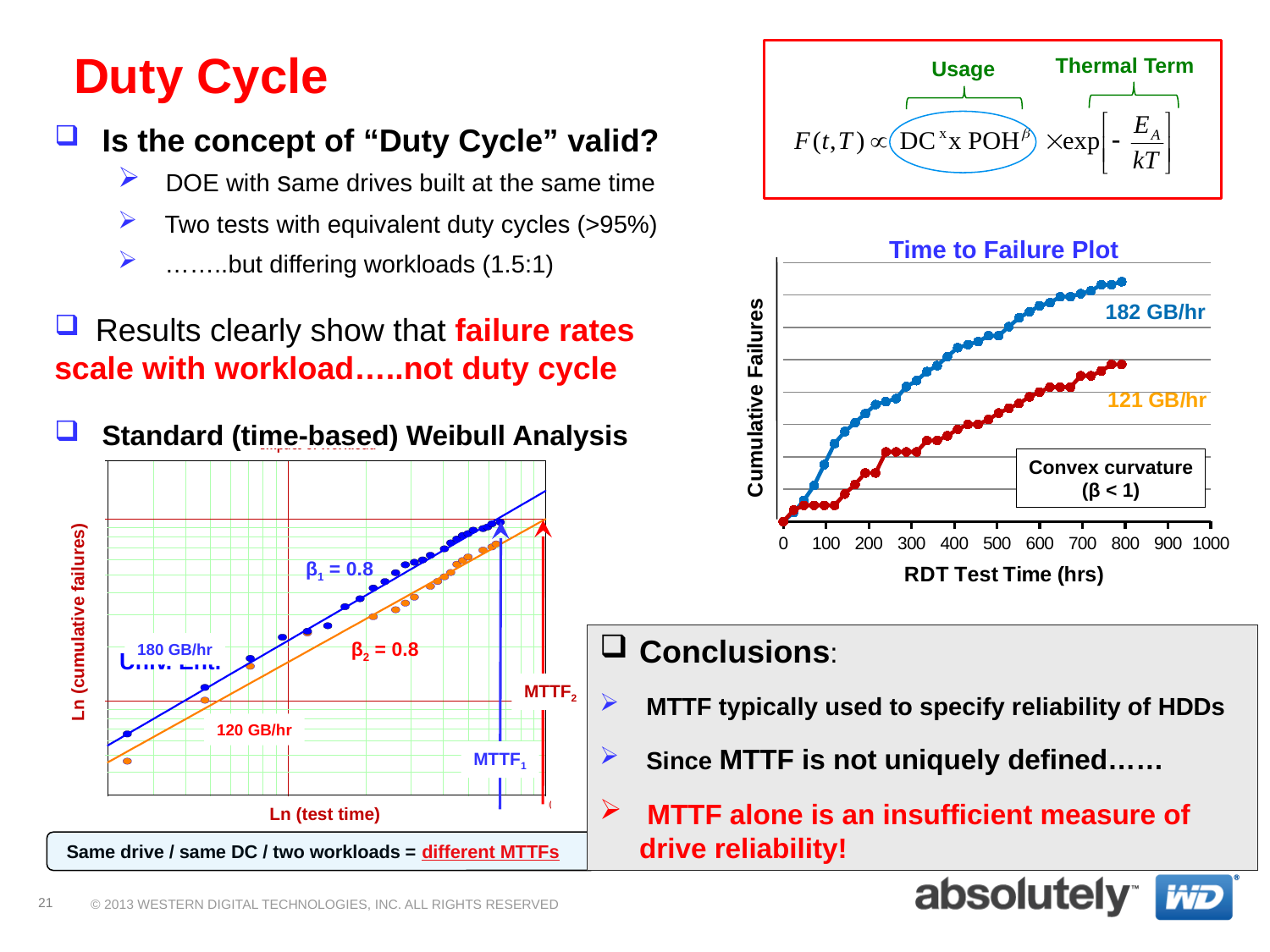
In the Weibull Analysis chart at the bottom left, which series lies higher on the plot, 180 GB/hr or 120 GB/hr? 180 GB/hr In the Time to Failure Plot, which series has the higher cumulative failures at 400 hours, 182 GB/hr or 121 GB/hr? 182 GB/hr In the Time to Failure Plot, what kind of chart is used to show the data? line chart In the Time to Failure Plot, what is the largest value shown on the x axis? 1000 In the Weibull Analysis chart at the bottom left, does Ln (cumulative failures) rise or fall as Ln (test time) increases? rise In the Weibull Analysis chart at the bottom left, what is the value of β1? 0.8 In the Time to Failure Plot, do cumulative failures rise or fall as RDT Test Time increases? rise In the Time to Failure Plot, what is the label of the x axis? RDT Test Time (hrs) In the Time to Failure Plot, what are the two series labelled? 182 GB/hr and 121 GB/hr In the Weibull Analysis chart at the bottom left, how many data series are plotted? 2 In the Time to Failure Plot, how many data series are plotted? 2